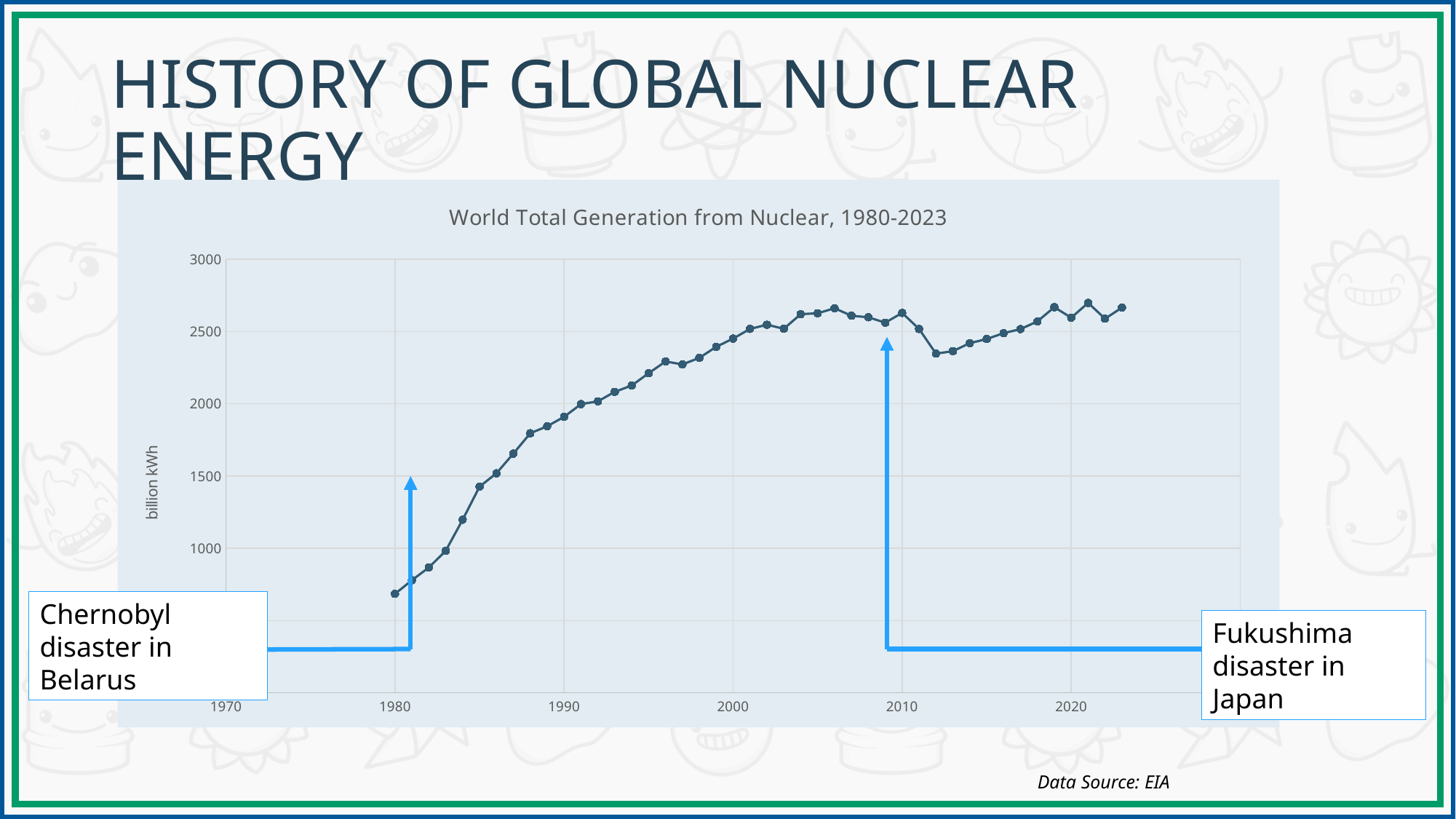
Which year has the lowest value on the chart? 1980 Is the value for 2006 greater or less than 2500? greater Is the value for 1980 greater or less than 1000? less Is the value for 2012 greater or less than 2500? less Which is larger, the value for 1985 or the value for 1995? 1995 Do the values rise or fall between 2010 and 2012? fall What is the title of the chart? World Total Generation from Nuclear, 1980-2023 What unit is shown on the y axis of the chart? billion kWh Do the values rise or fall between 1980 and 2000? rise What kind of chart is shown on the slide? line chart